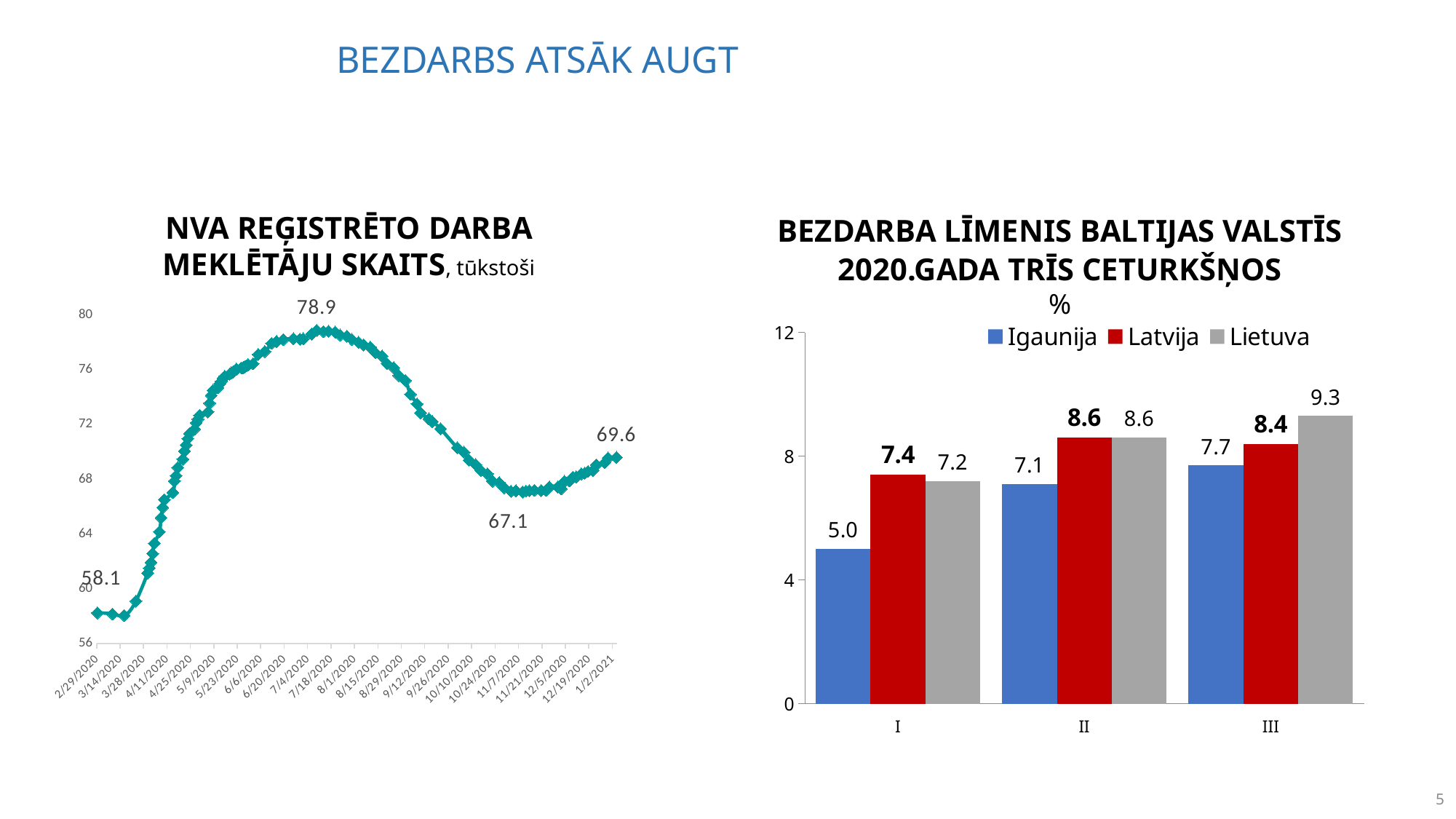
In the chart 'BEZDARBA LĪMENIS BALTIJAS VALSTĪS 2020.GADA TRĪS CETURKŠŅOS', what is the value for Igaunija in quarter I? 5.0 How many series does the legend of the chart 'BEZDARBA LĪMENIS BALTIJAS VALSTĪS 2020.GADA TRĪS CETURKŠŅOS' list? 3 In the chart 'BEZDARBA LĪMENIS BALTIJAS VALSTĪS 2020.GADA TRĪS CETURKŠŅOS', which is larger: Lietuva in quarter III or Latvija in quarter III? Lietuva in quarter III What kind of chart is 'BEZDARBA LĪMENIS BALTIJAS VALSTĪS 2020.GADA TRĪS CETURKŠŅOS'? Bar chart In the chart 'BEZDARBA LĪMENIS BALTIJAS VALSTĪS 2020.GADA TRĪS CETURKŠŅOS', which country has the highest value in quarter III? Lietuva In the chart 'BEZDARBA LĪMENIS BALTIJAS VALSTĪS 2020.GADA TRĪS CETURKŠŅOS', what is the value for Latvija in quarter II? 8.6 In the chart 'NVA REĢISTRĒTO DARBA MEKLĒTĀJU SKAITS', what is the peak value labelled on the line? 78.9 In the chart 'NVA REĢISTRĒTO DARBA MEKLĒTĀJU SKAITS', what is the value labelled at the end of the line (1/2/2021)? 69.6 What kind of chart is 'NVA REĢISTRĒTO DARBA MEKLĒTĀJU SKAITS'? Line chart In the chart 'BEZDARBA LĪMENIS BALTIJAS VALSTĪS 2020.GADA TRĪS CETURKŠŅOS', what is the difference between Latvija and Igaunija in quarter I? 2.4 In the chart 'BEZDARBA LĪMENIS BALTIJAS VALSTĪS 2020.GADA TRĪS CETURKŠŅOS', what is the value for Lietuva in quarter III? 9.3 In the chart 'BEZDARBA LĪMENIS BALTIJAS VALSTĪS 2020.GADA TRĪS CETURKŠŅOS', which country has the lowest value in quarter I? Igaunija